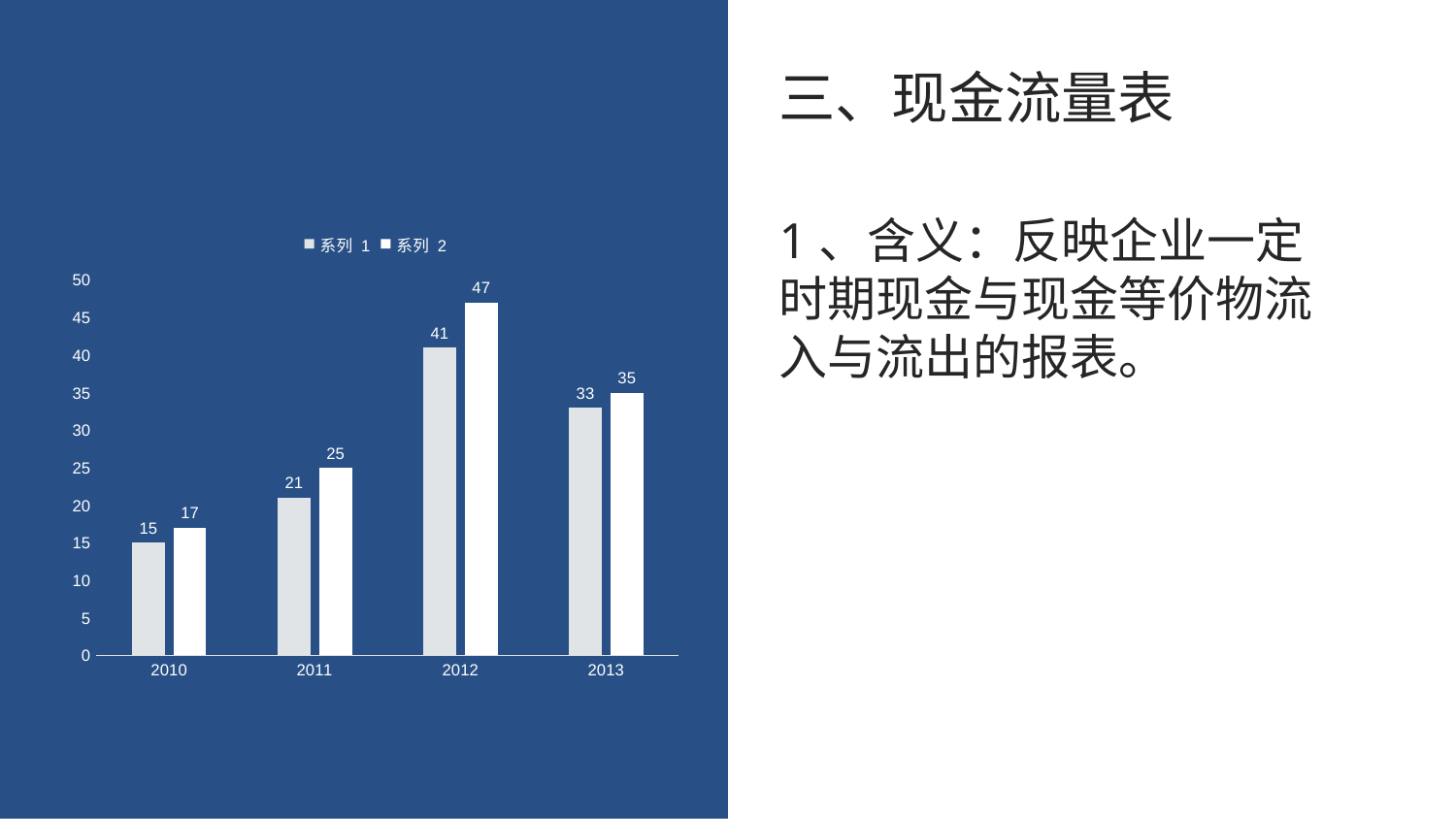
What is the difference between the 系列 1 values for 2012 and 2013? 8 What is the value of 系列 2 for 2010? 17 Does 系列 2 rise or fall from 2010 to 2012? Rise How many years are shown on the x axis? 4 Which year has the highest value for 系列 2? 2012 Which is larger: 系列 1 in 2013 or 系列 2 in 2011? 系列 1 in 2013 What is the difference between 系列 2 and 系列 1 in 2011? 4 How many series does the legend list? 2 What is the value of 系列 1 for 2012? 41 Which year has the lowest value for 系列 1? 2010 What kind of chart is shown on the slide? Bar chart What is the value of 系列 2 for 2013? 35